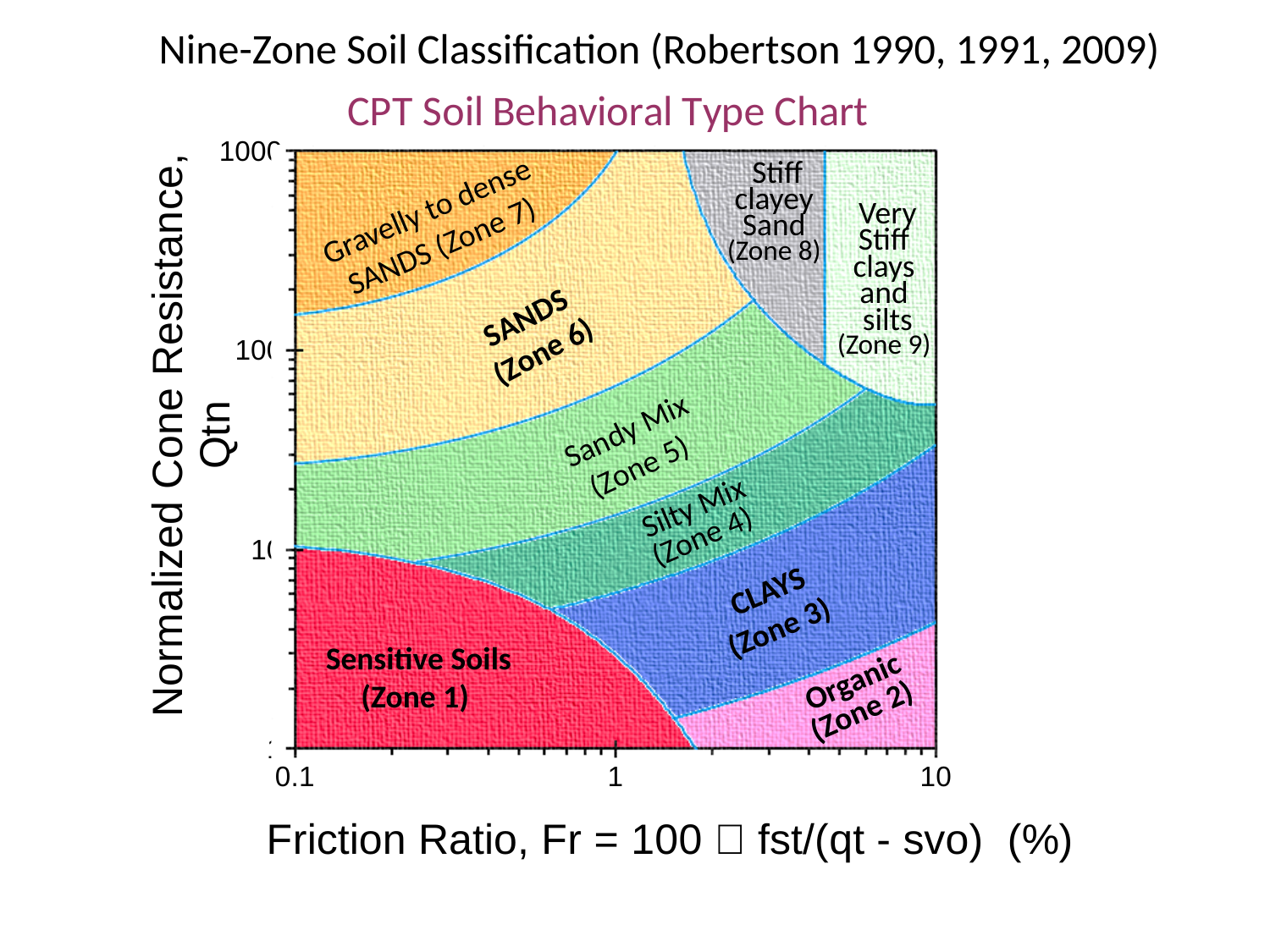
What is the label of the y axis? Normalized Cone Resistance, Qtn Which soil type is labeled as Zone 1? Sensitive Soils How many soil zones are shown on the chart? 9 What is the highest value shown on the y axis? 1000 What is the title of the chart? CPT Soil Behavioral Type Chart Which zone number is assigned to Stiff clayey Sand? Zone 8 Which zone number is assigned to Silty Mix? Zone 4 Which zone number is assigned to Organic soils? Zone 2 Which soil type is labeled as Zone 3? CLAYS What is the lowest value shown on the x axis? 0.1 Which soil type is labeled as Zone 9? Very Stiff clays and silts Which soil type is labeled as Zone 7? Gravelly to dense SANDS